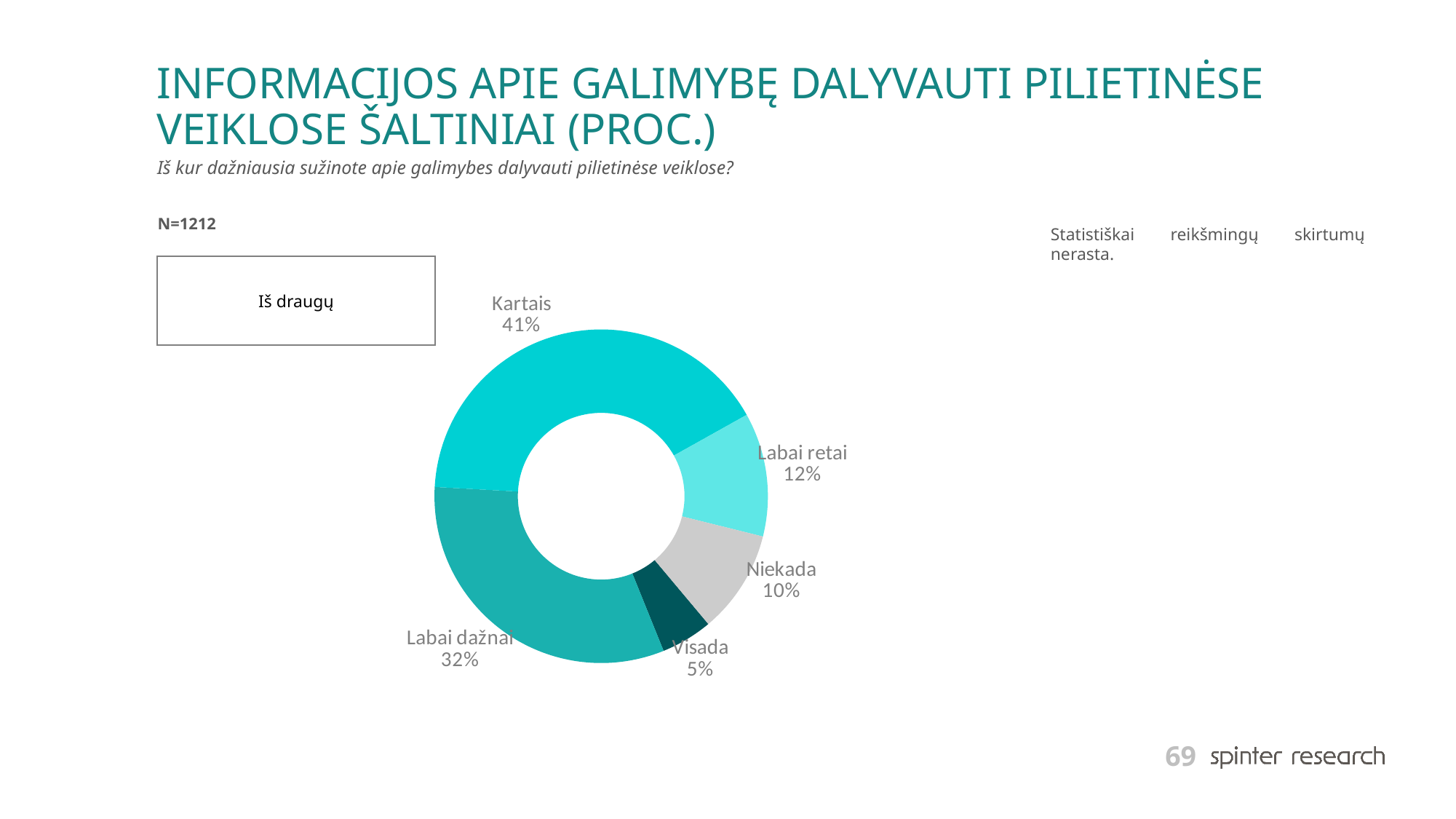
What percentage of respondents answered "Visada"? 5% What percentage of respondents answered "Kartais"? 41% Which is larger, the share for "Labai retai" or the share for "Niekada"? Labai retai What percentage of respondents answered "Labai retai"? 12% What percentage of respondents answered "Labai dažnai"? 32% What type of chart is shown on the slide? Pie chart (doughnut) Which response category has the largest share of the pie? Kartais What percentage of respondents answered "Niekada"? 10% What is the sample size (N) stated on the slide? N=1212 How many response categories are shown in the pie chart? 5 What is the difference in percentage points between "Kartais" and "Labai dažnai"? 9 Which response category has the smallest share of the pie? Visada